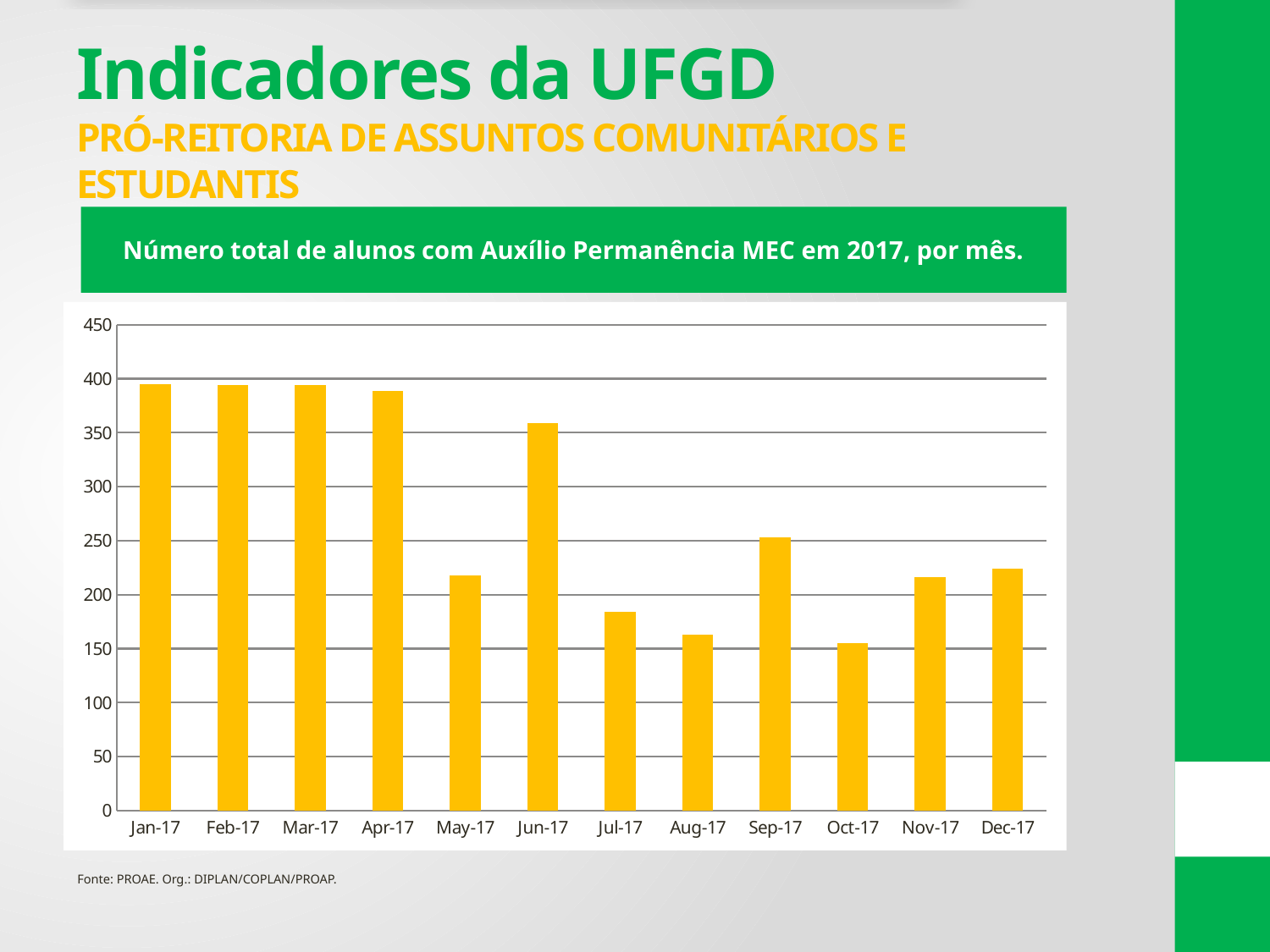
Is the value for Nov-17 greater or less than 200? greater Which month has the lowest number of students with Auxílio Permanência MEC? Oct-17 Which is larger, the value for Jun-17 or the value for May-17? Jun-17 Is the value for May-17 greater or less than 250? less Is the value for Jun-17 greater or less than 300? greater Overall, do the values rise or fall from Jan-17 to Dec-17? fall What kind of chart is shown on the slide? bar chart How many months are plotted on the x axis of the chart? 12 Which is larger, the value for Sep-17 or the value for Aug-17? Sep-17 What is the title of the chart? Número total de alunos com Auxílio Permanência MEC em 2017, por mês.